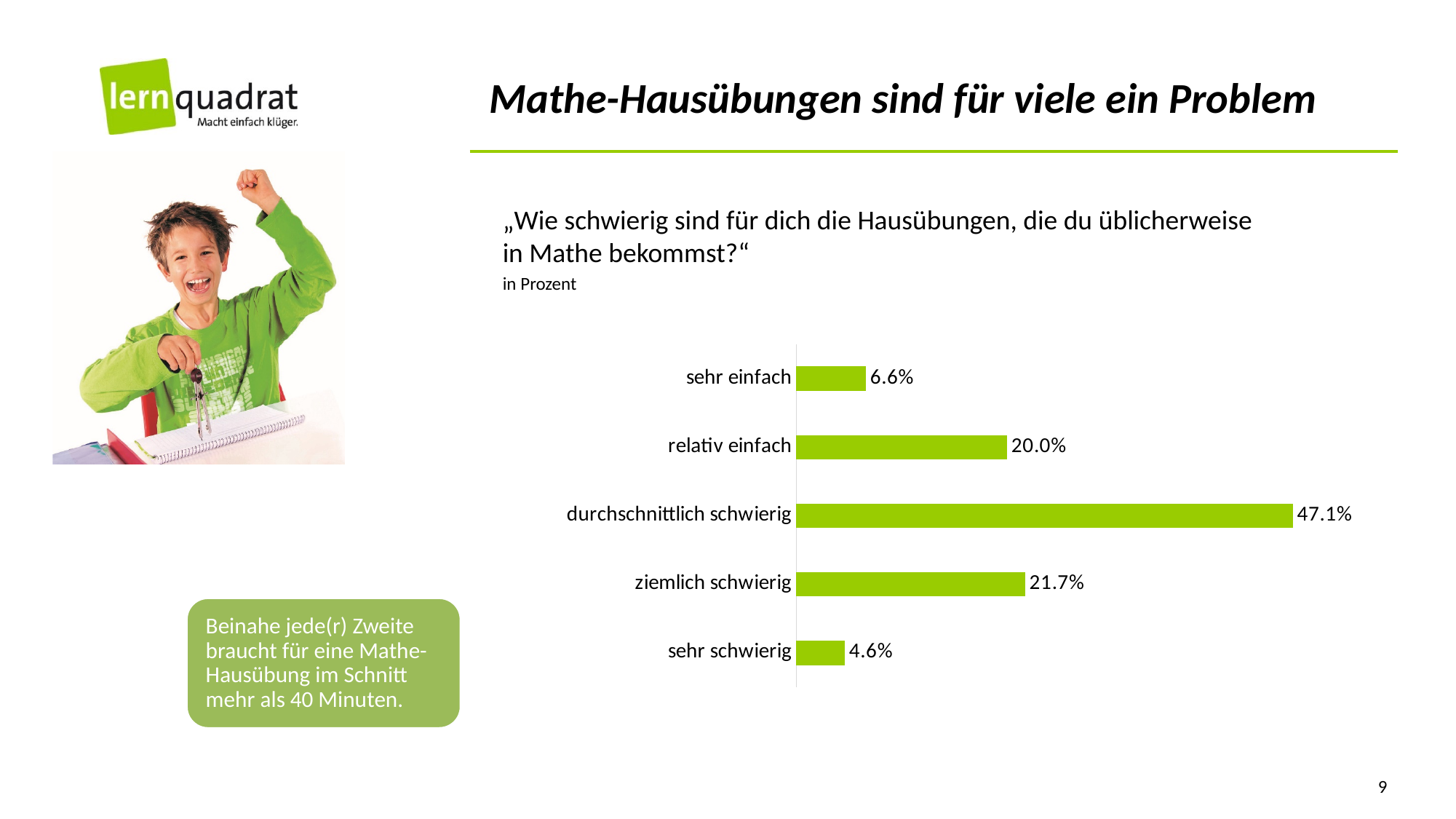
How many categories are shown in the chart? 5 What percentage is shown for "ziemlich schwierig"? 21.7% What is the difference between the values for "ziemlich schwierig" and "relativ einfach"? 1.7% Which category has the highest value? durchschnittlich schwierig What is the value for "sehr schwierig"? 4.6% What kind of chart is shown on the slide? bar chart Which is larger, the value for "relativ einfach" or the value for "sehr einfach"? relativ einfach What is the difference between "sehr einfach" and "sehr schwierig"? 2.0% What percentage of respondents answered "durchschnittlich schwierig"? 47.1% What colour are the bars in the chart? green What is the value shown for "sehr einfach"? 6.6% Which category has the lowest value? sehr schwierig